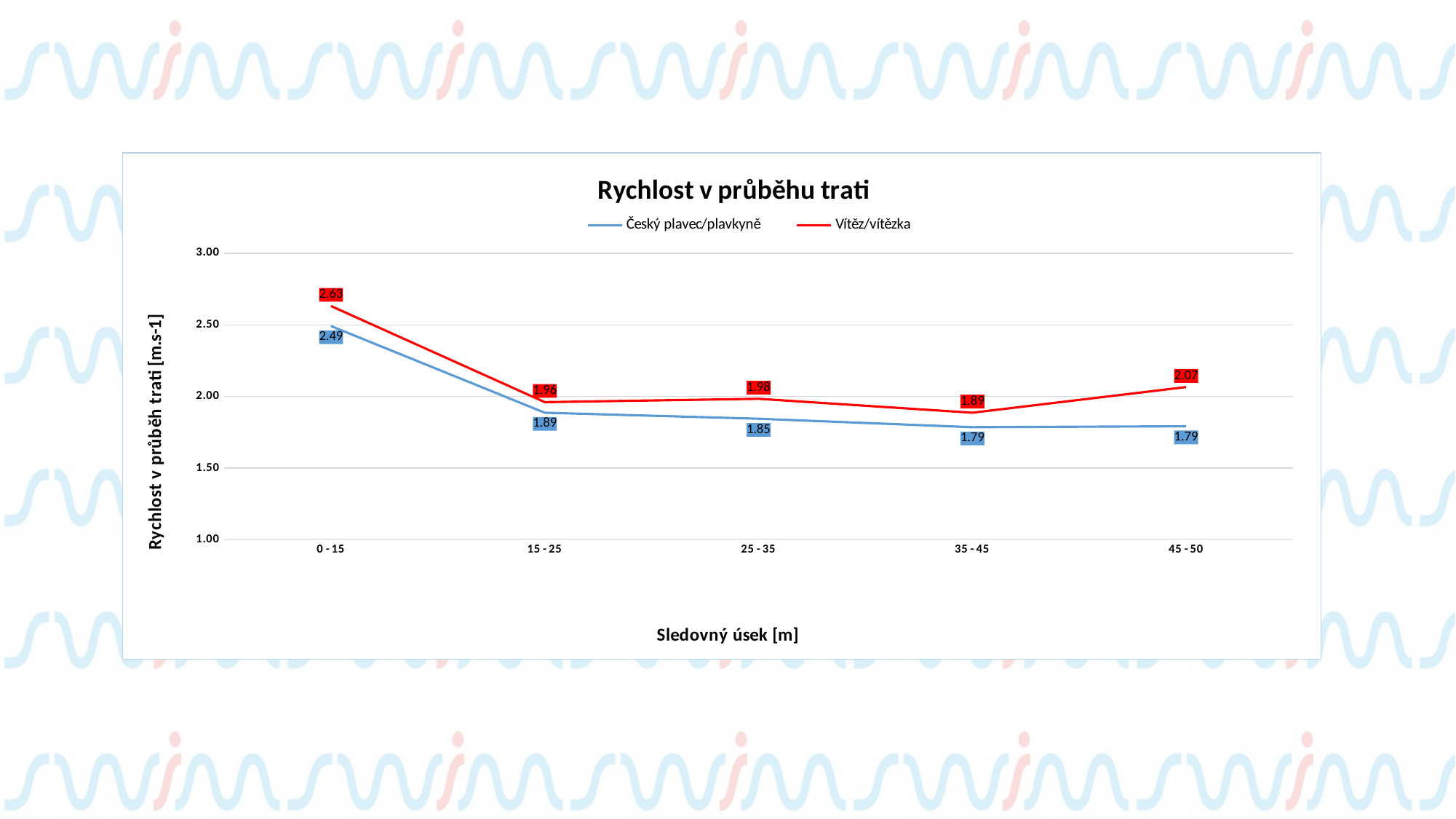
In which segment is the Český plavec/plavkyně value highest? 0 - 15 How many series does the legend list? 2 What is the value for Vítěz/vítězka in the 0 - 15 segment? 2.63 Which series has the larger value in the 15 - 25 segment? Vítěz/vítězka What is the difference between the Vítěz/vítězka and Český plavec/plavkyně values in the 45 - 50 segment? 0.28 How many segments (categories) are shown on the x axis? 5 What is the value for Český plavec/plavkyně in the 25 - 35 segment? 1.85 What type of chart is shown on the slide? line chart Does the Český plavec/plavkyně series generally rise or fall from the 0 - 15 segment to the 45 - 50 segment? fall What is the title of the chart? Rychlost v průběhu trati What is the value for Vítěz/vítězka in the 45 - 50 segment? 2.07 In which segment is the Vítěz/vítězka value lowest? 35 - 45